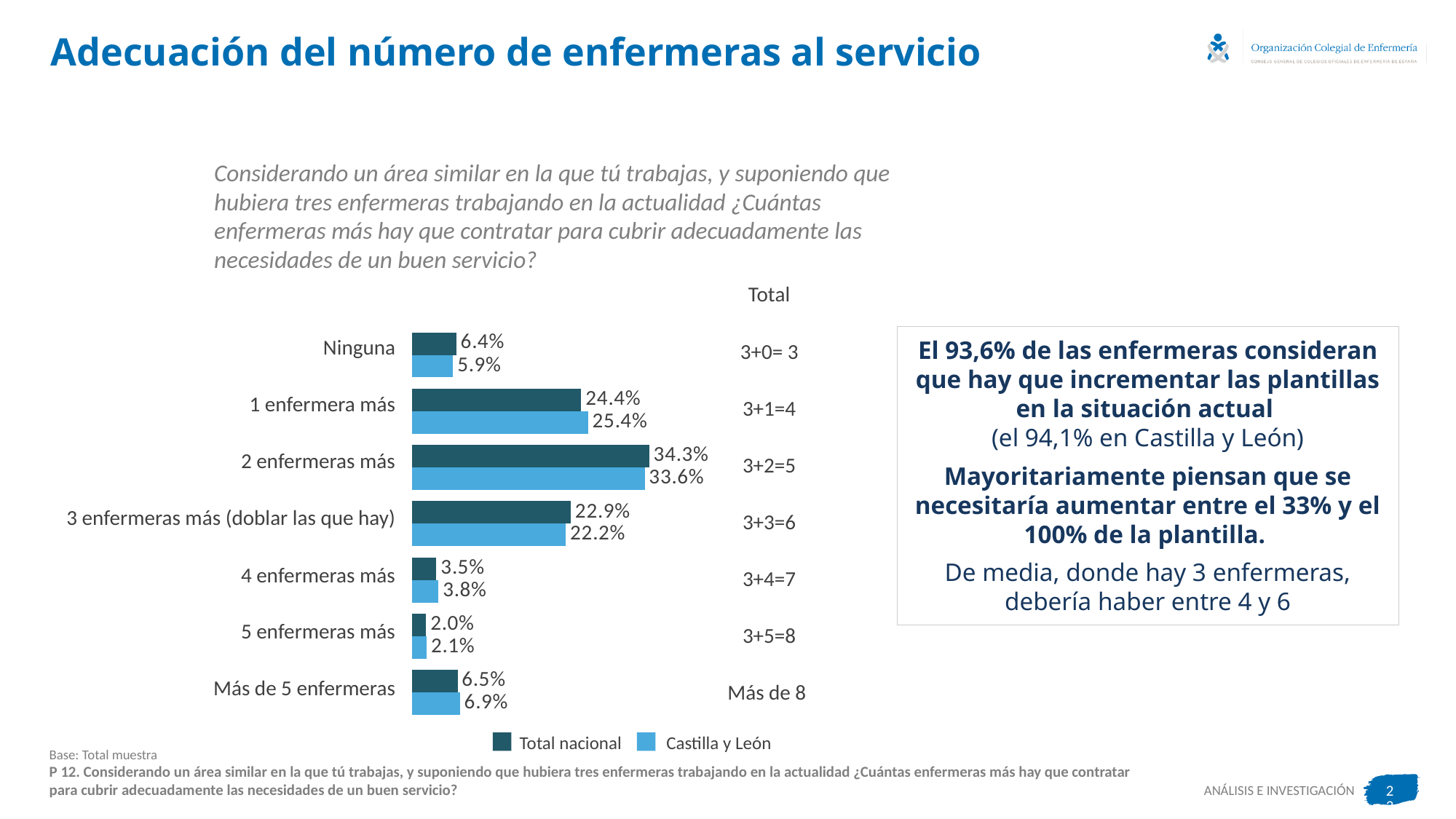
Which series is shown in the darker colour in the legend? Total nacional What is the difference between the Total nacional and Castilla y León values for '3 enfermeras más (doblar las que hay)'? 0.7% Which is larger for '4 enfermeras más': Total nacional or Castilla y León? Castilla y León What kind of chart is shown on the slide? Bar chart Which category has the highest Total nacional value? 2 enfermeras más What is the Castilla y León value for 'Ninguna'? 5.9% What is the Castilla y León value for '1 enfermera más'? 25.4% Which category has the lowest Castilla y León value? 5 enfermeras más What is the Total nacional value for '2 enfermeras más'? 34.3% How many series does the legend list? 2 How many categories are shown on the chart? 7 What is the difference between the Total nacional values for '2 enfermeras más' and '1 enfermera más'? 9.9%